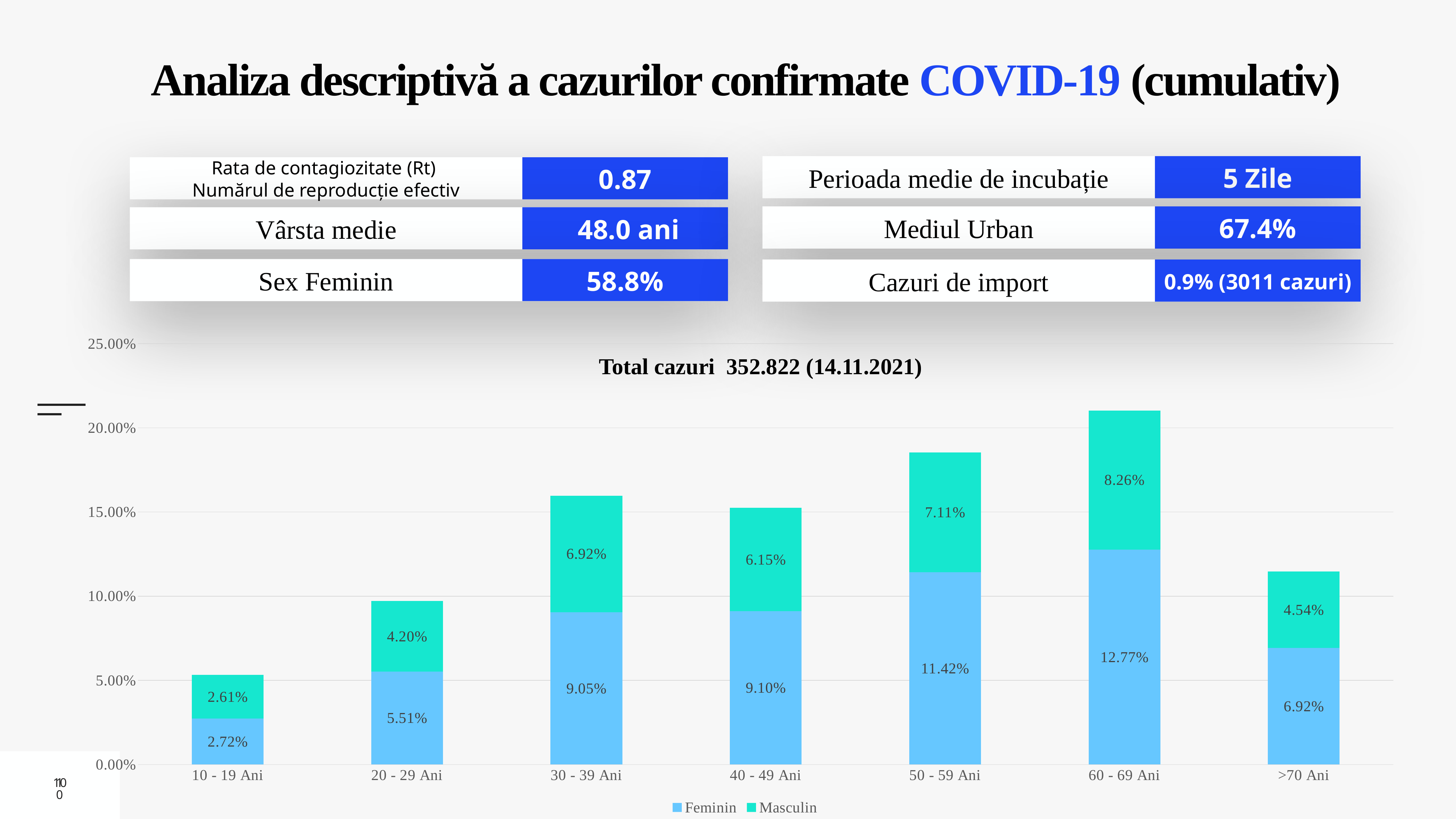
What is the Masculin value for the 20 - 29 Ani age group? 4.20% What is the Feminin value for the 60 - 69 Ani age group? 12.77% How many series does the chart legend list? 2 What kind of chart is shown on the slide? Stacked bar chart Which is larger, the Masculin value for 30 - 39 Ani or the Masculin value for 40 - 49 Ani? 30 - 39 Ani Is the total height of the stacked bar for 60 - 69 Ani greater or less than 20.00%? greater What is the difference between the Feminin and Masculin values for the 50 - 59 Ani age group? 4.31% How many age groups are shown on the x axis of the chart? 7 Which age group has the lowest Masculin value? 10 - 19 Ani What is the total of the stacked bar for the 10 - 19 Ani age group? 5.33% What is the Feminin value for the >70 Ani age group? 6.92% Which age group has the highest Feminin value? 60 - 69 Ani